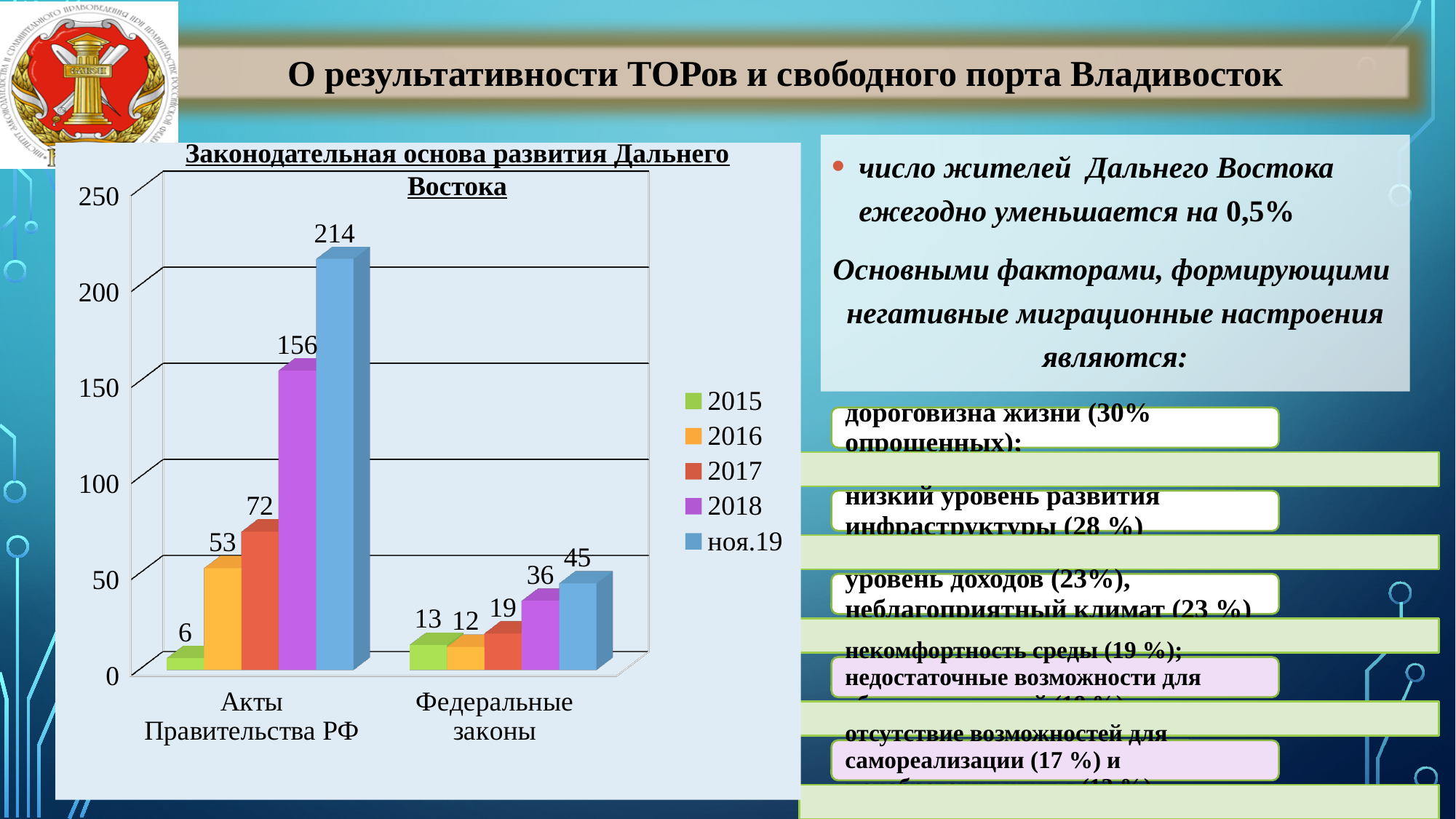
What is the value for ноя.19 in the Федеральные законы category? 45 How many categories are shown on the x axis? 2 What is the title of the chart? Законодательная основа развития Дальнего Востока Which series has the lowest value in the Федеральные законы category? 2016 Which is larger: the 2016 value for Акты Правительства РФ or the 2016 value for Федеральные законы? Акты Правительства РФ What is the difference between the ноя.19 and 2018 values for Акты Правительства РФ? 58 What is the difference between the 2017 values for Акты Правительства РФ and Федеральные законы? 53 What is the value for 2015 in the Акты Правительства РФ category? 6 What is the value for 2018 in the Акты Правительства РФ category? 156 How many series does the legend list? 5 Which series has the highest value in the Акты Правительства РФ category? ноя.19 What kind of chart is shown on the slide? Bar chart